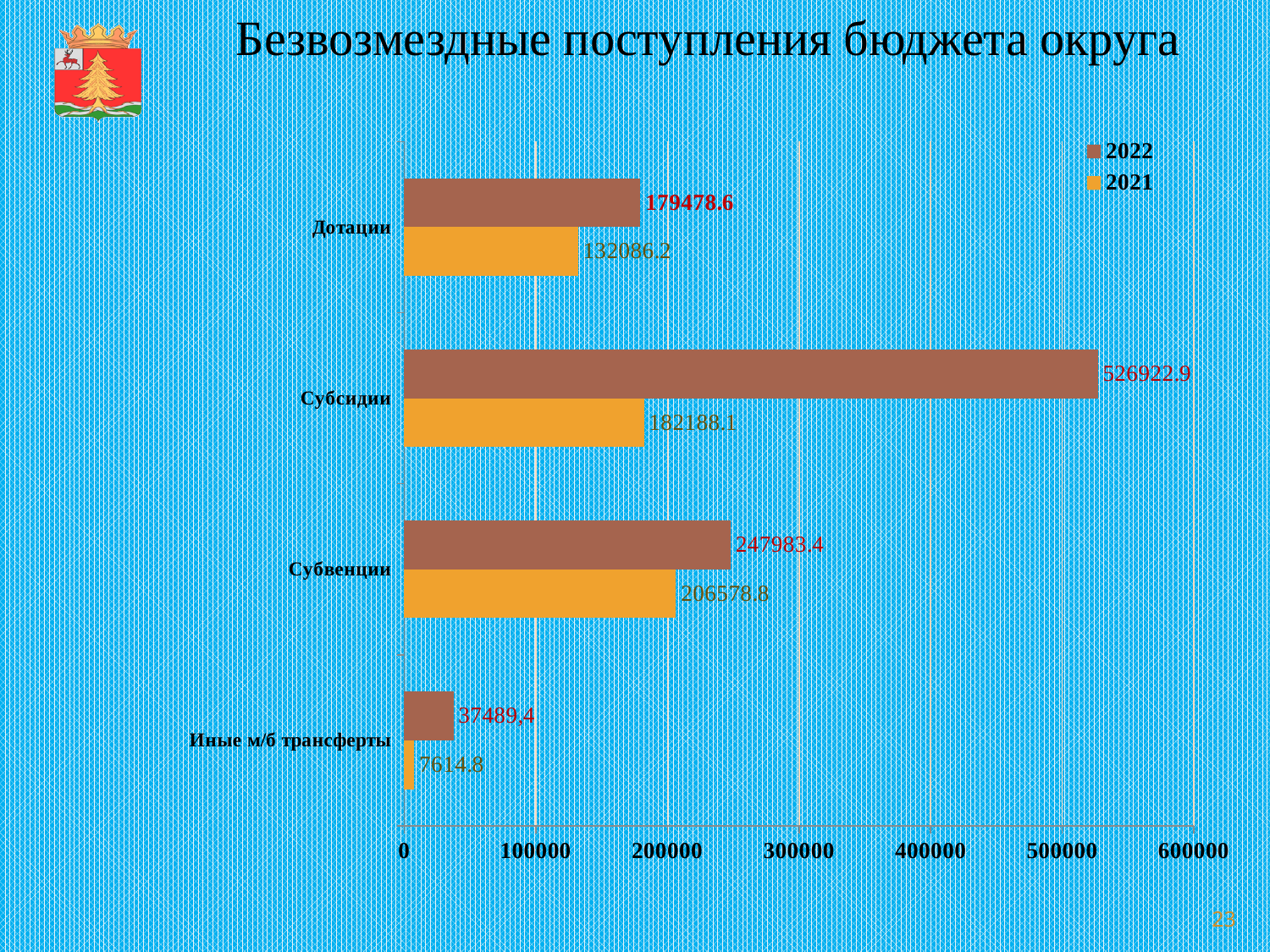
How many categories are shown on the chart? 4 What is the difference between the 2022 and 2021 values for Дотации? 47392.4 What is the 2022 value for Субвенции? 247983.4 Which is larger: the 2021 value for Субвенции or the 2021 value for Субсидии? Субвенции What is the 2021 value for Дотации? 132086.2 Which category has the lowest 2021 value? Иные м/б трансферты Which category has the highest 2022 value? Субсидии What is the 2022 value for Субсидии? 526922.9 What type of chart is shown on the slide? bar chart What is the 2021 value for Иные м/б трансферты? 7614.8 How many series does the legend list? 2 What is the difference between the 2022 and 2021 values for Субсидии? 344734.8